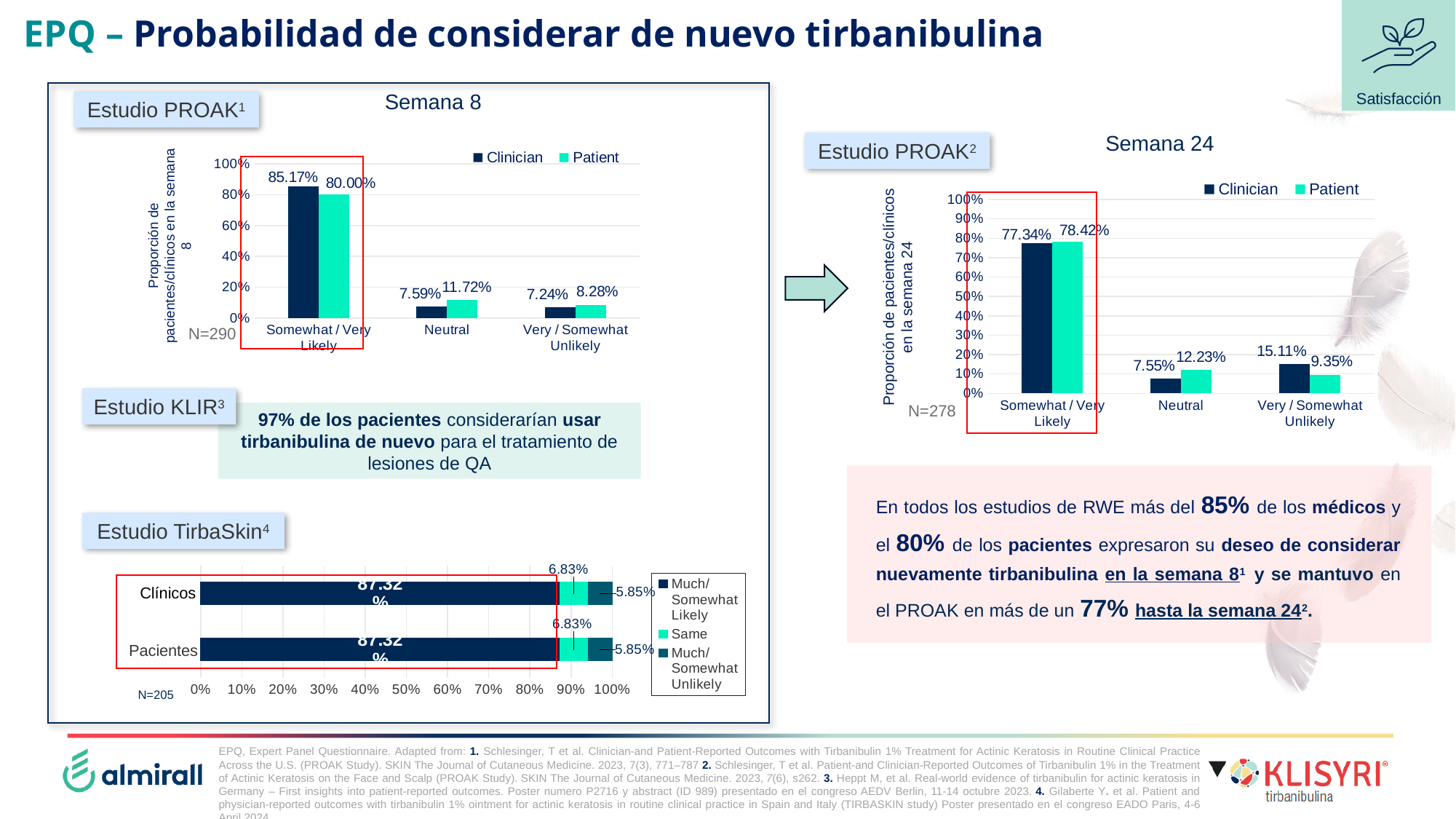
In the Estudio TirbaSkin chart, what is the Much/Somewhat Likely value for Clínicos? 87.32% In the Semana 8 chart, what is the difference between the Clinician and Patient values for Somewhat / Very Likely? 5.17 percentage points In the Semana 24 chart, what is the Patient value for Somewhat / Very Likely? 78.42% In the Semana 24 chart, which category has the highest Clinician value? Somewhat / Very Likely In the Semana 24 chart, which is larger for Neutral, the Clinician value or the Patient value? Patient In the Estudio TirbaSkin chart, what is the total of the Pacientes stacked bar? 100.00% In the Semana 8 chart, what is the Patient value for Neutral? 11.72% In the Semana 8 chart, what is the Clinician value for Somewhat / Very Likely? 85.17% How many series does the legend of the Semana 8 chart list? 2 In the Semana 24 chart, what is the Clinician value for Very / Somewhat Unlikely? 15.11% How many categories are shown on the x axis of the Semana 24 chart? 3 What kind of chart is the Estudio TirbaSkin chart at the bottom left? Stacked horizontal bar chart